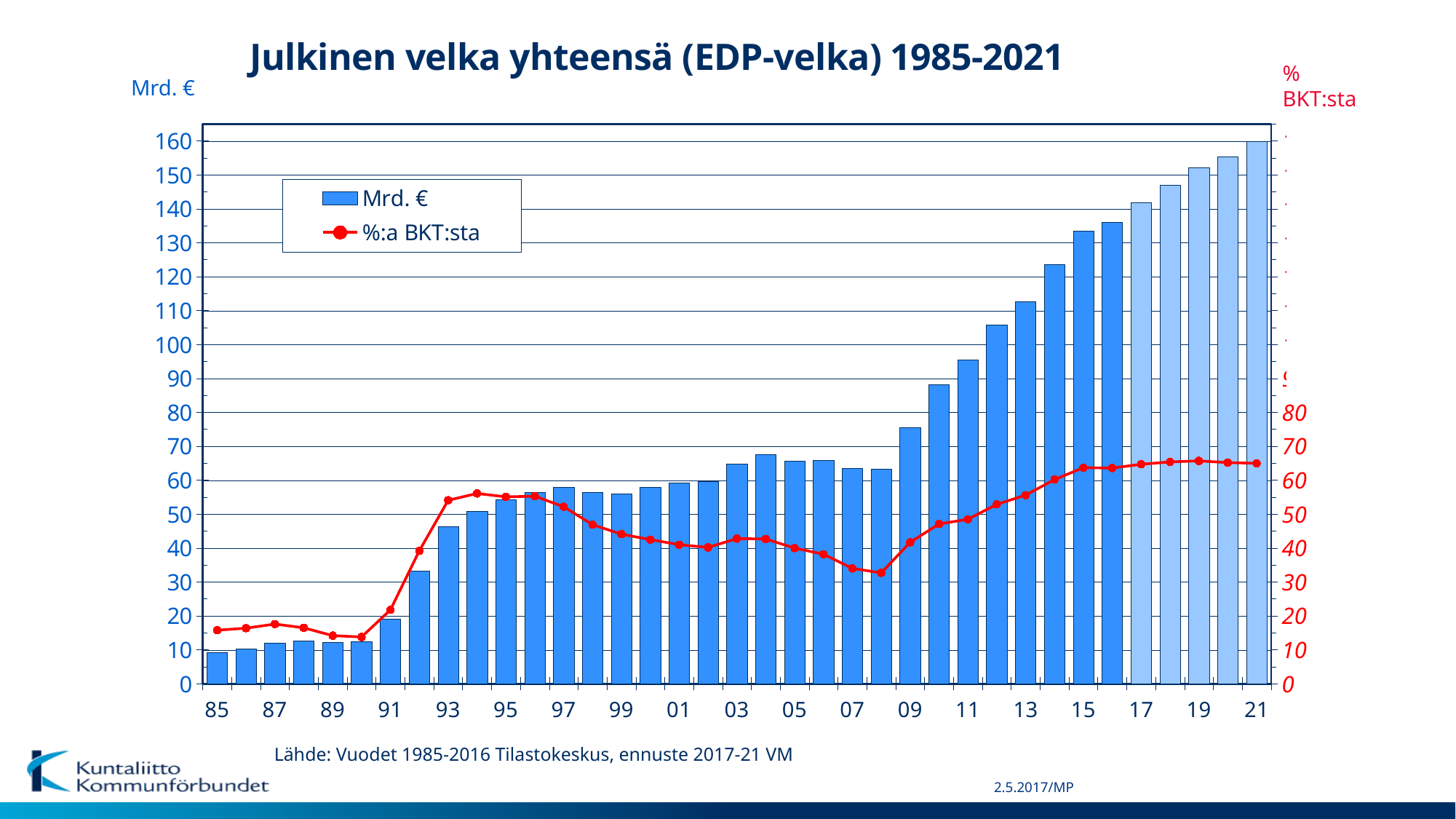
Is the %:a BKT:sta value for 2008 (08) greater or less than 40? less What kind of chart is shown on the slide? A bar chart combined with a line Which is larger, the Mrd. € bar for 2009 (09) or for 2008 (08)? 2009 (09) Is the Mrd. € bar for 2010 (10) greater or less than 90? less Overall, do the Mrd. € bars rise or fall from 1985 to 2021? rise Which year has the lowest bar for Mrd. €? 85 (1985) How many years (bars) are plotted on the chart? 37 How many series does the legend list? 2 What are the two series named in the legend? Mrd. € and %:a BKT:sta Is the Mrd. € bar for 2016 (16) greater or less than 130? greater Which year has the highest bar for Mrd. €? 21 (2021)